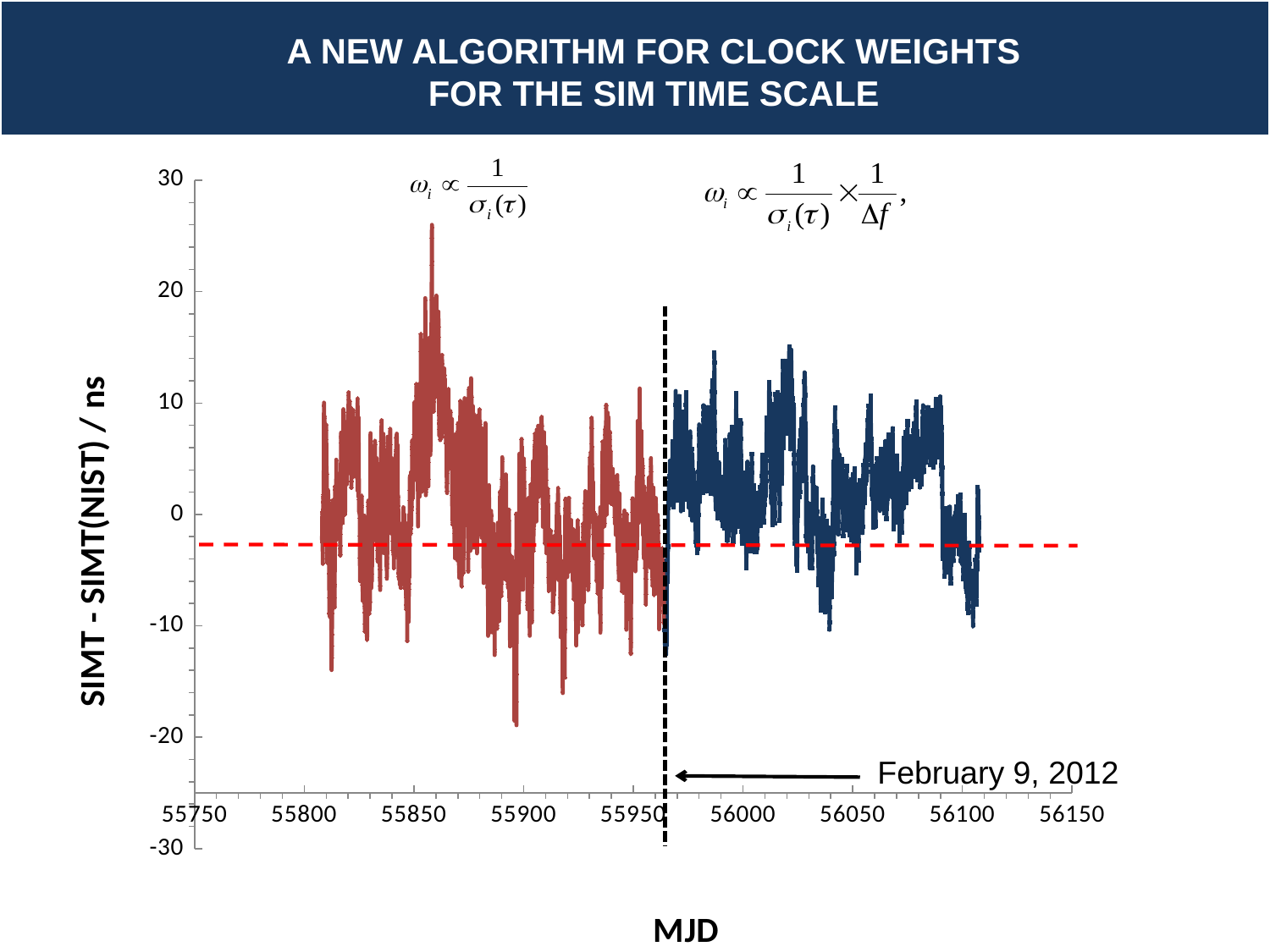
Is the highest peak of the blue segment of the line greater or less than 10? greater What is the label of the y axis? SIMT - SIMT(NIST) / ns Is the lowest point of the red segment of the line greater or less than -10? less Is the highest peak of the red segment of the line greater or less than 20? greater What is the lowest value shown on the x axis? 55750 What kind of chart is shown on the slide? line chart Which segment of the line reaches a higher maximum value, the red segment or the blue segment? the red segment What is the label of the x axis? MJD What is the highest value shown on the y axis? 30 What date does the arrow annotation next to the vertical dashed line indicate? February 9, 2012